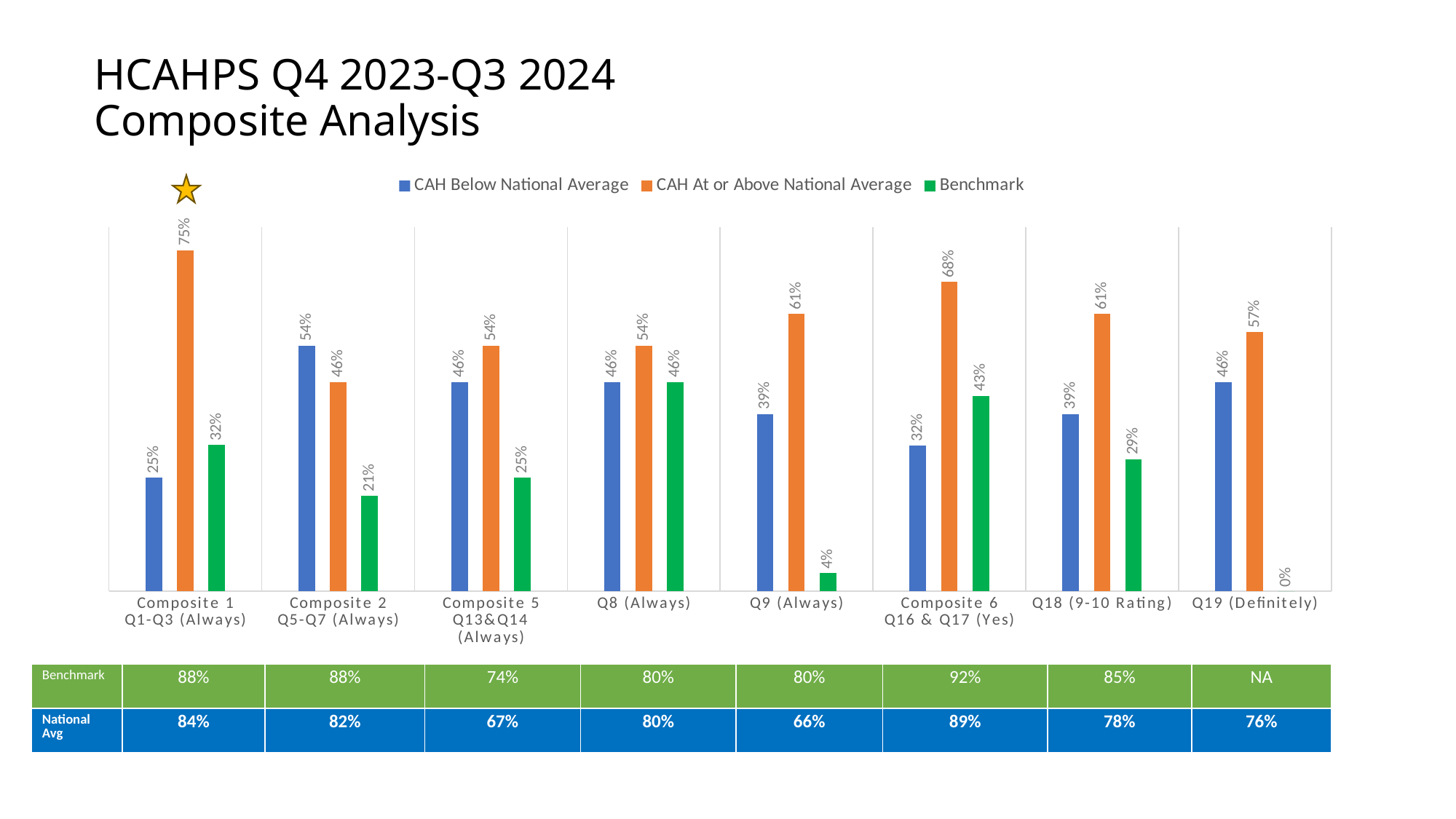
Which category has the highest CAH Below National Average value? Composite 2 Q5-Q7 (Always) How many categories are shown along the x axis of the chart? 8 What is the difference between the CAH At or Above National Average and CAH Below National Average values for Q9 (Always)? 22% Which category has the highest CAH At or Above National Average value? Composite 1 Q1-Q3 (Always) Which category has the lowest Benchmark value? Q19 (Definitely) What type of chart is shown on the slide? bar chart What is the value of CAH Below National Average for Composite 6 Q16 & Q17 (Yes)? 32% For Composite 2 Q5-Q7 (Always), which is larger: CAH Below National Average or CAH At or Above National Average? CAH Below National Average What is the Benchmark value for Q9 (Always)? 4% How many series does the chart legend list? 3 What is the value of CAH At or Above National Average for Composite 1 Q1-Q3 (Always)? 75% What colour are the Benchmark bars in the chart? green